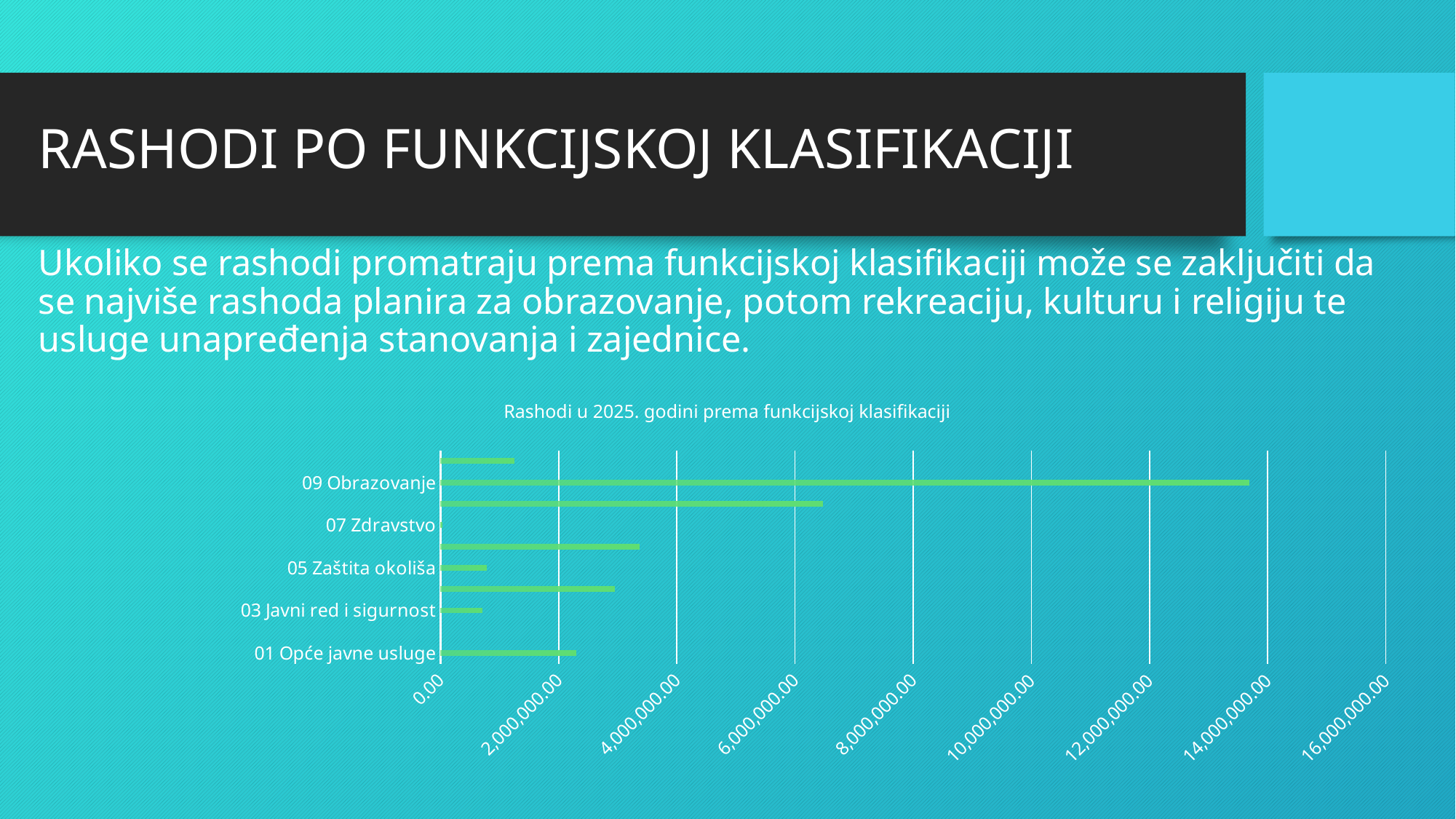
Is the value for 05 Zaštita okoliša greater or less than 2,000,000.00? less Which of the labelled categories has the highest value? 09 Obrazovanje Is the value for 01 Opće javne usluge greater or less than 4,000,000.00? less Is the value for 03 Javni red i sigurnost greater or less than 2,000,000.00? less Which is larger, the value for 01 Opće javne usluge or the value for 03 Javni red i sigurnost? 01 Opće javne usluge What is the title of the chart? Rashodi u 2025. godini prema funkcijskoj klasifikaciji Which is larger, the value for 09 Obrazovanje or the value for 01 Opće javne usluge? 09 Obrazovanje What is the highest value shown on the horizontal axis? 16,000,000.00 What kind of chart is shown on the slide? bar chart